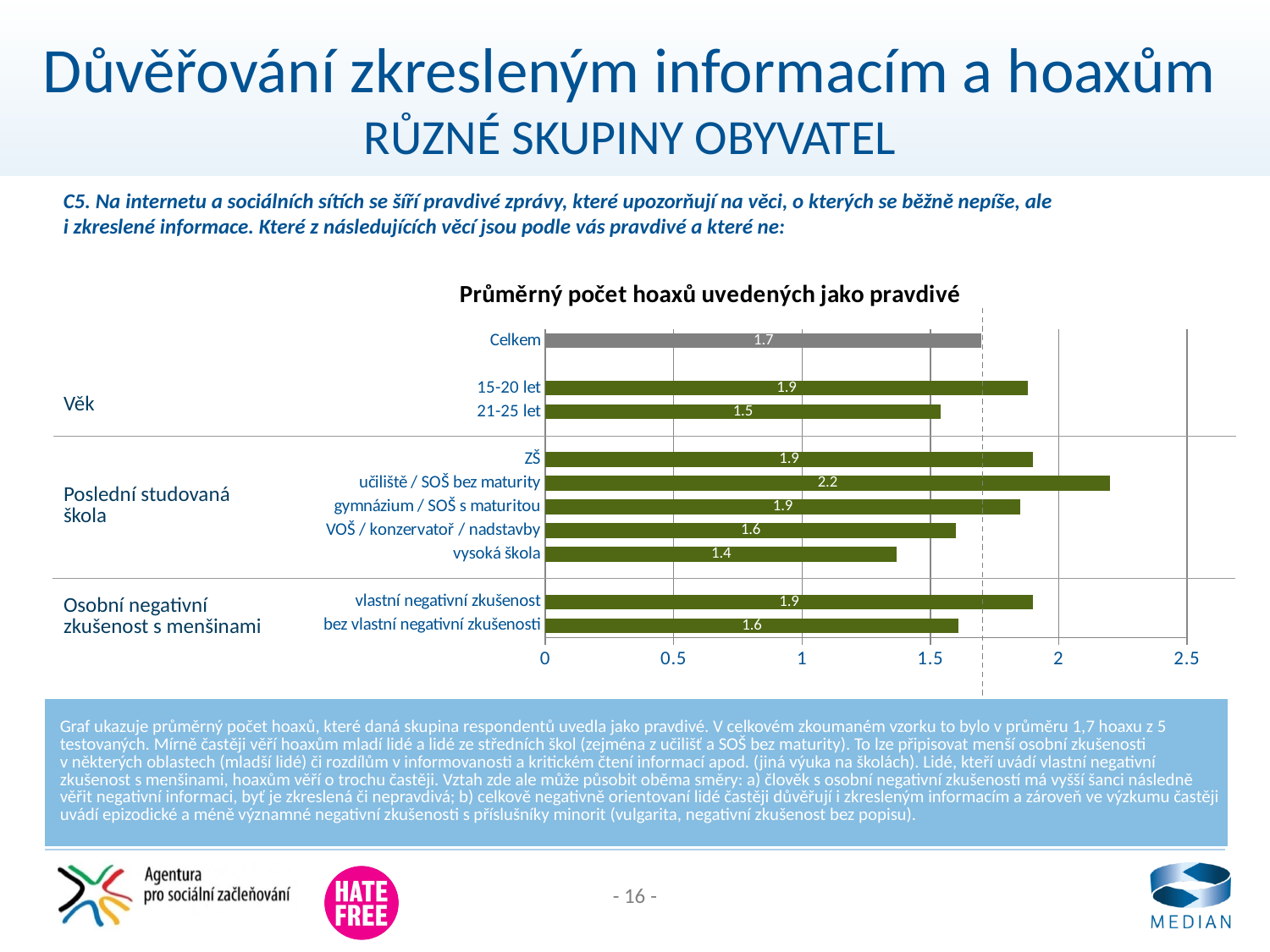
What is the value for "bez vlastní negativní zkušenosti"? 1.6 Is the value for "učiliště / SOŠ bez maturity" greater or less than 2? greater What kind of chart is shown on the slide? bar chart What is the value for "vysoká škola"? 1.4 How many bars are plotted in the chart? 10 What is the value for "Celkem" in the chart? 1.7 What is the title of the chart? Průměrný počet hoaxů uvedených jako pravdivé What is the difference between the values for "15-20 let" and "21-25 let"? 0.4 Which is larger: the value for "vlastní negativní zkušenost" or for "bez vlastní negativní zkušenosti"? vlastní negativní zkušenost Which category has the lowest value in the chart? vysoká škola What is the average number of hoaxes believed true for the "15-20 let" group? 1.9 Which category has the highest value in the chart? učiliště / SOŠ bez maturity